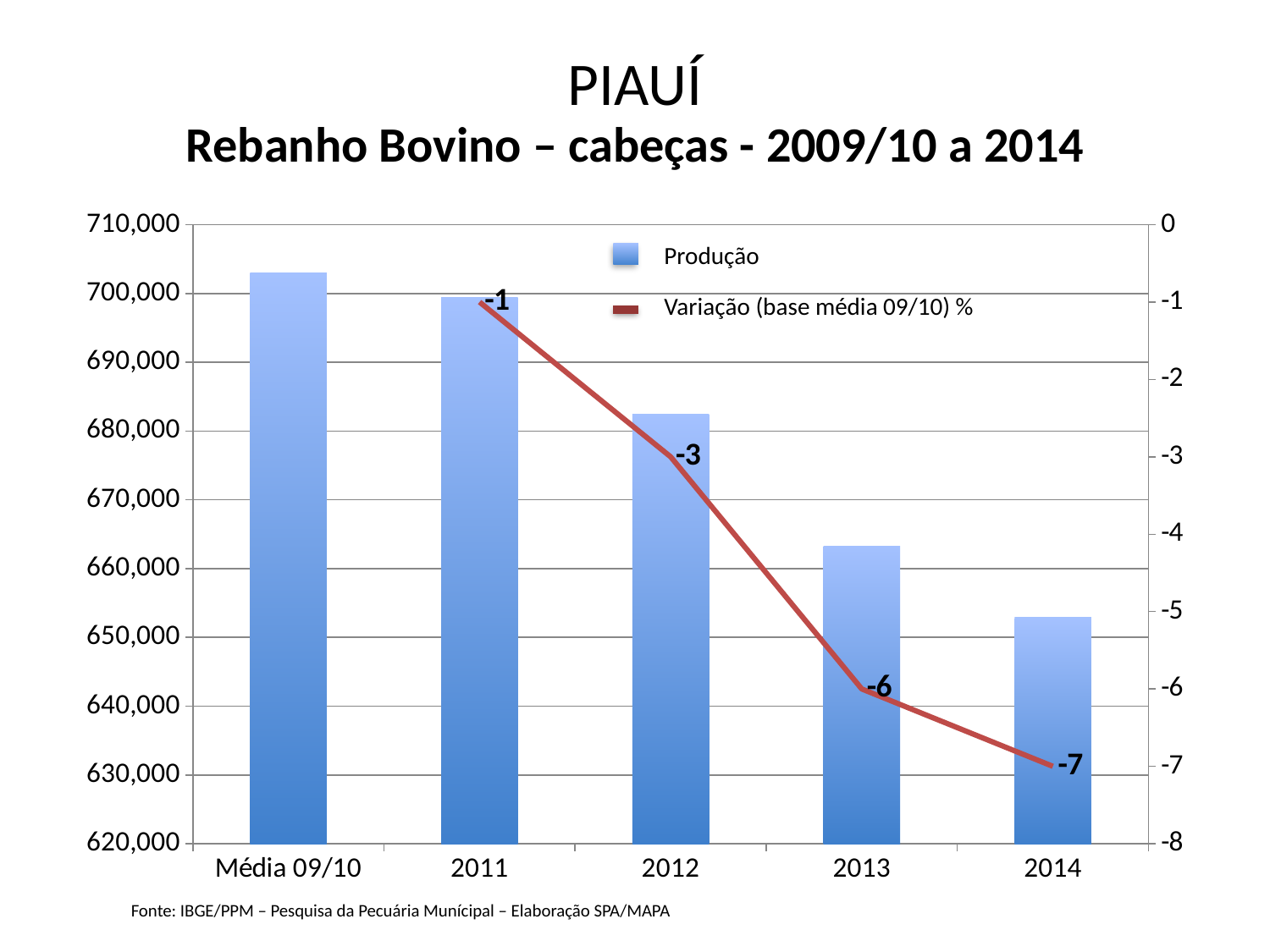
Do the Produção bars rise or fall from Média 09/10 to 2014? fall Which category has the highest Produção bar? Média 09/10 How many series does the legend list? 2 What is the Variação (base média 09/10) % value for 2011? -1 What is the difference between the Variação values for 2012 and 2014? 4 Which has a larger Produção bar, 2011 or 2013? 2011 Is the Produção bar for 2014 greater or less than 660,000? less How many categories are shown on the x axis? 5 Which year has the lowest Produção bar? 2014 What is the Variação (base média 09/10) % value for 2014? -7 What is the Variação (base média 09/10) % value for 2013? -6 Is the Produção bar for 2012 greater or less than 680,000? greater